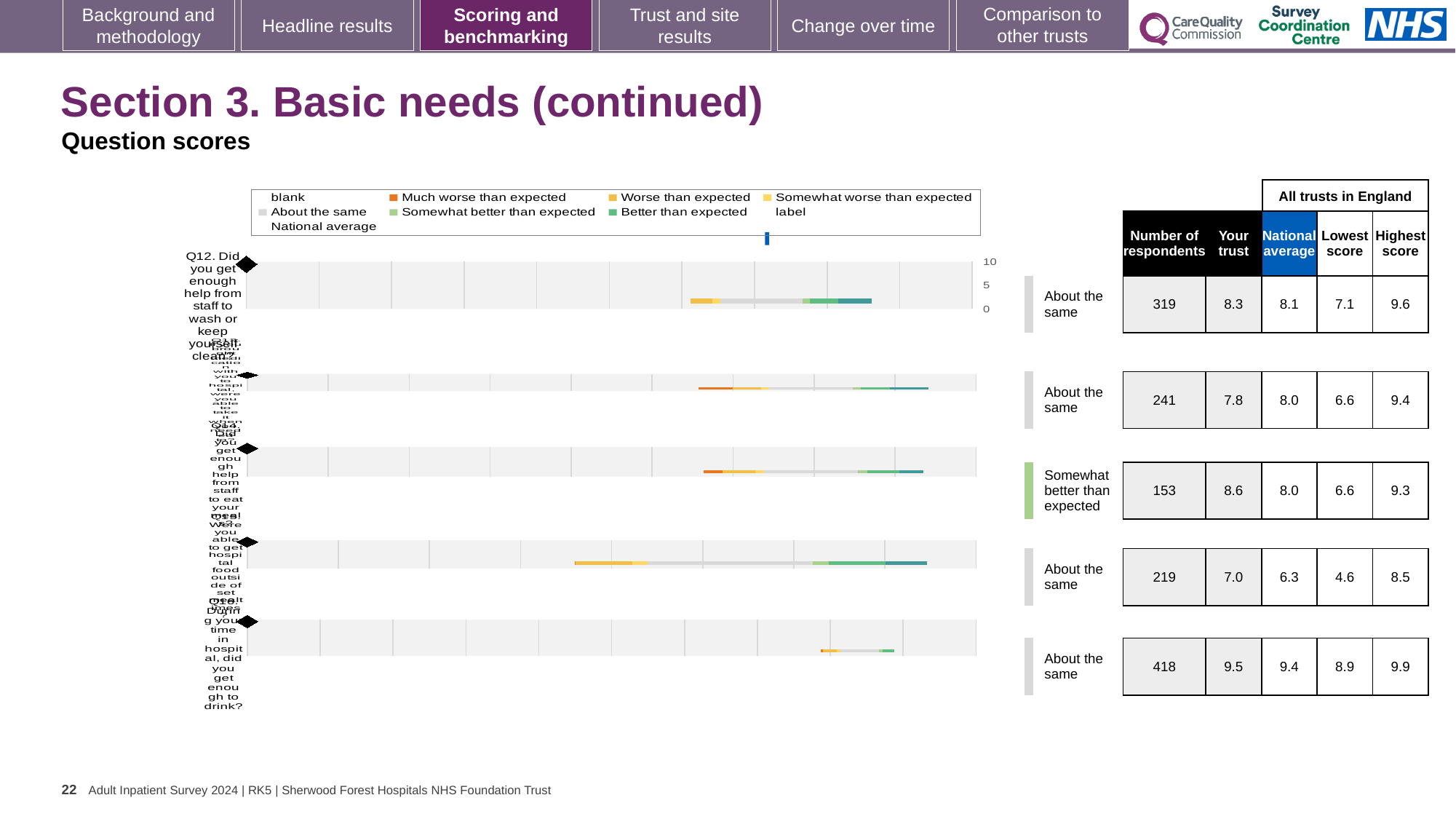
What is the smallest 'Lowest score' value shown in the table beside the chart? 4.6 In the table beside the chart, what is the 'Your trust' score for the bottom row (did you get enough to drink)? 9.5 What kind of chart is shown on the slide? bar chart In the table beside the chart, how many respondents answered Q12 (help from staff to wash or keep yourself clean)? 319 Which row has the highest 'Your trust' score in the table beside the chart? the bottom row (did you get enough to drink), 9.5 For Q12, which is higher: the 'Your trust' score or the national average? Your trust How many question rows (bars) does the chart show? 5 For Q12, what is the difference between the highest score (9.6) and the lowest score (7.1) across all trusts in England? 2.5 Which row is rated 'Somewhat better than expected'? the third row How many of the five rows are rated 'About the same'? 4 In the table beside the chart, what is the 'Your trust' score for Q12 (help from staff to wash or keep yourself clean)? 8.3 In the table beside the chart, what is the national average for the bottom row (did you get enough to drink)? 9.4